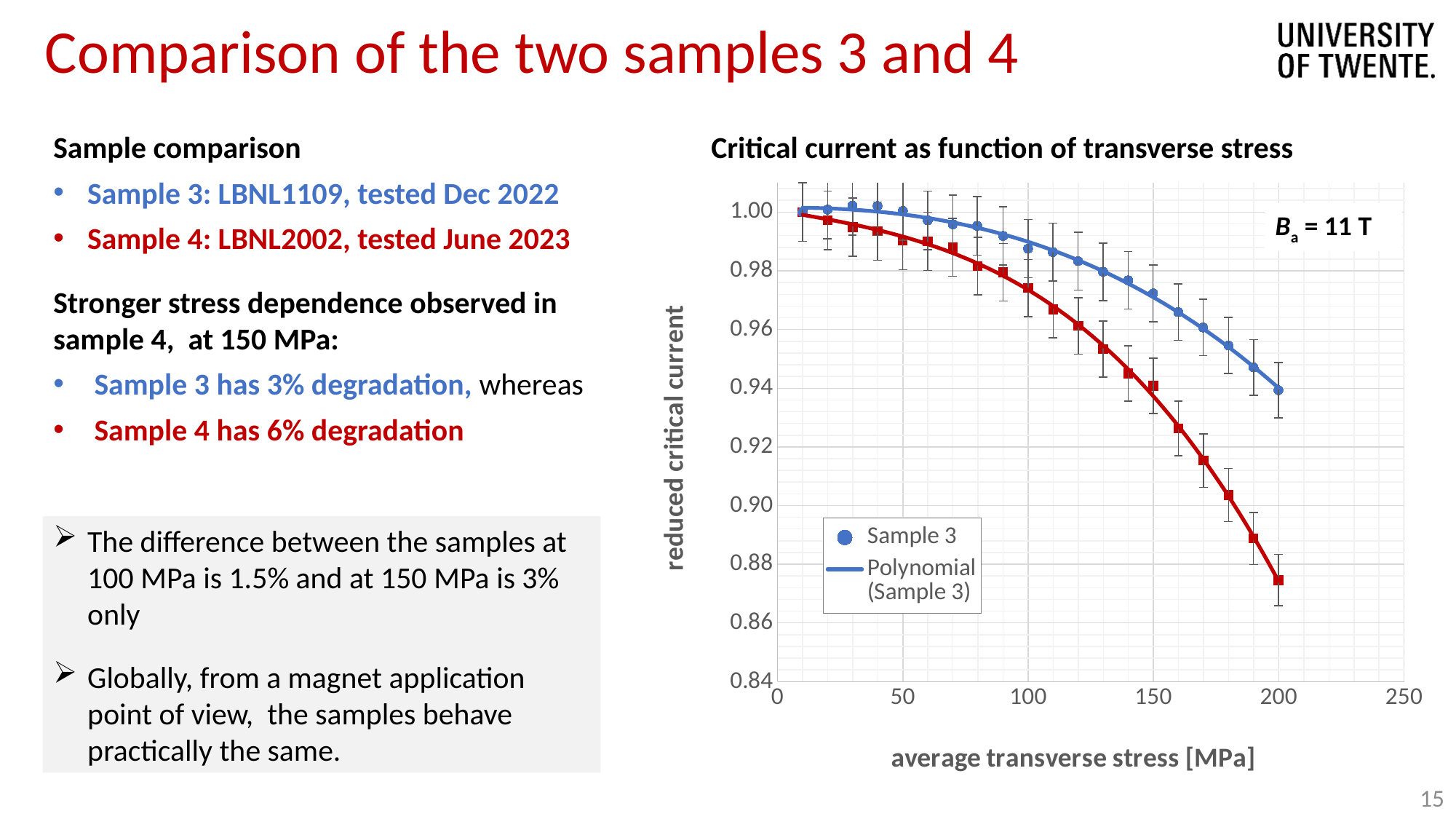
Is the reduced critical current of the red series at 150 MPa greater or less than 0.96? less What is the label of the x axis of the chart? average transverse stress [MPa] Is the reduced critical current of the blue series (Sample 3) at 200 MPa greater or less than 0.92? greater Is the reduced critical current of the blue series (Sample 3) at 100 MPa greater or less than 0.98? greater How many entries does the chart legend list? 2 Which series reaches the lowest reduced critical current on the chart, the blue series or the red series? the red series What is the title of the chart? Critical current as function of transverse stress Do the reduced critical current values rise or fall as the average transverse stress increases? fall At 200 MPa, which series has the higher reduced critical current, the blue series (Sample 3) or the red series? the blue series (Sample 3) What kind of chart is shown on the slide? Scatter chart with polynomial fit lines